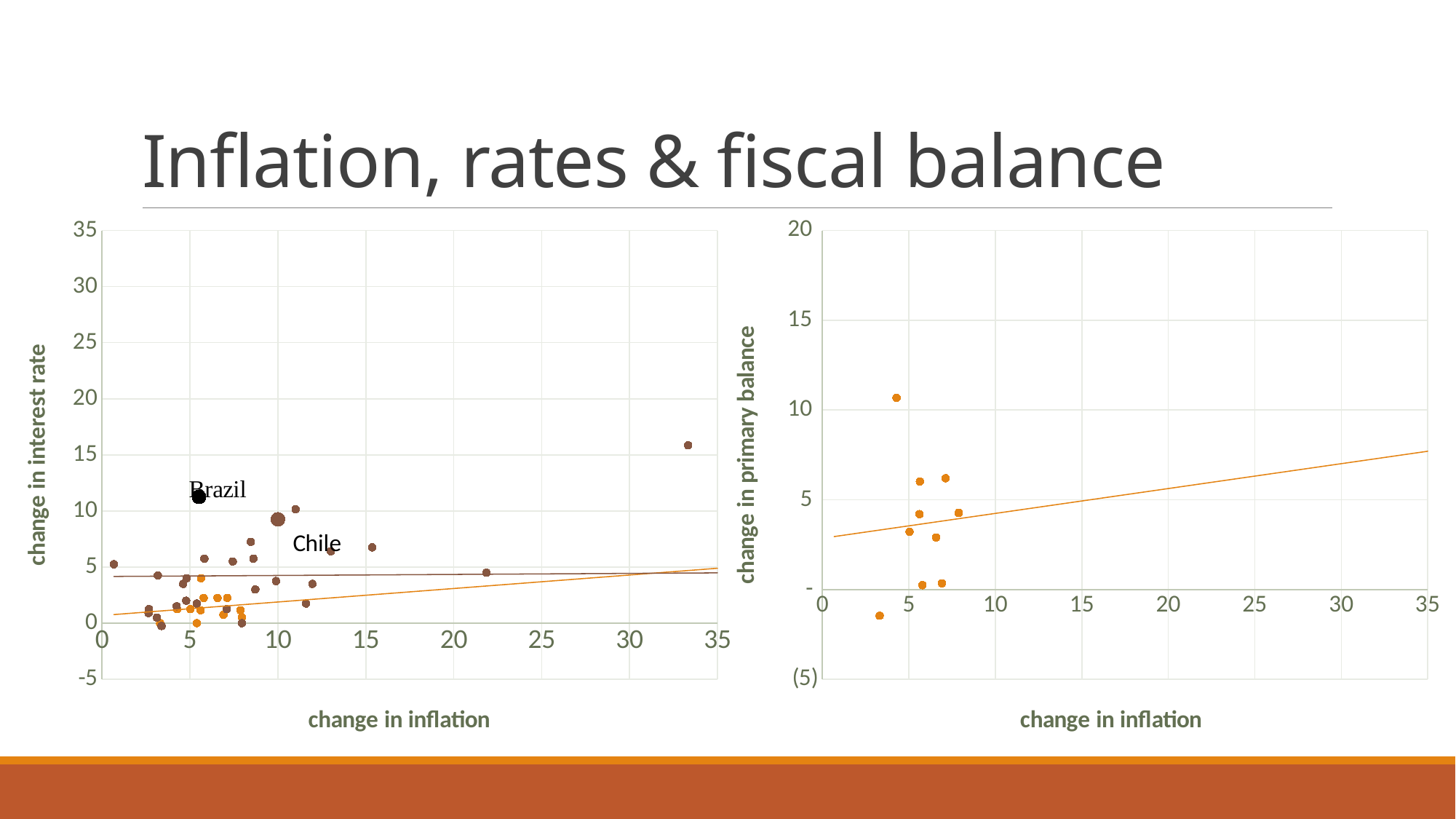
On the left chart, which labelled country has the higher change in interest rate, Brazil or Chile? Brazil On the right chart, does the fitted trend line rise or fall as change in inflation increases? rises What kind of chart is the right chart, with y axis 'change in primary balance'? scatter chart On the left chart, is the change in interest rate for Brazil greater or less than 5? greater On the right chart, is the highest change in primary balance greater or less than 10? greater On the right chart, is the lowest change in primary balance greater or less than 0? less How many data points are plotted on the right chart? 10 What is the x-axis title of the right chart? change in inflation What kind of chart is the left chart, with y axis 'change in interest rate'? scatter chart